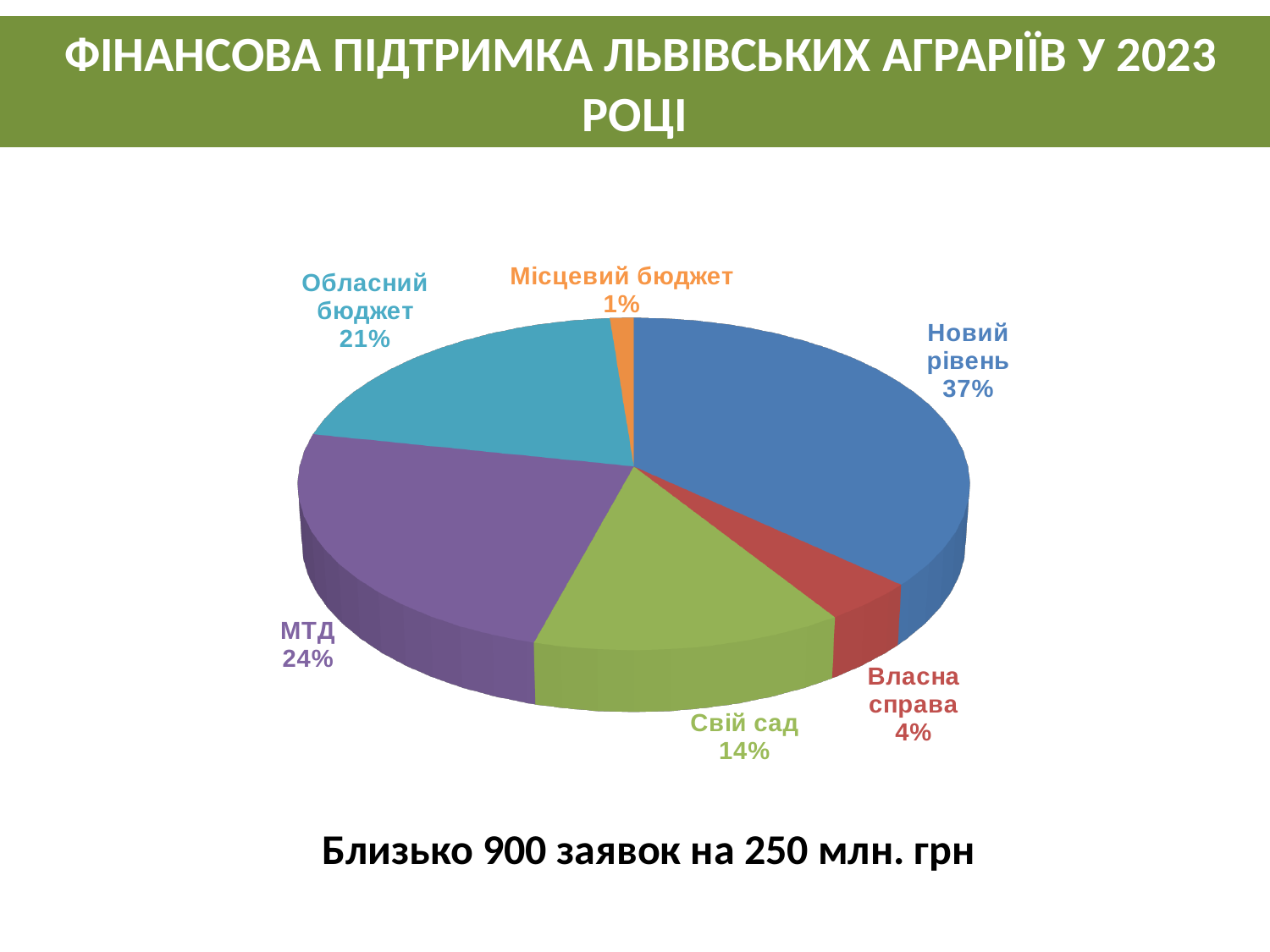
What share of the pie does "Місцевий бюджет" have? 1% What is the difference in percentage points between "Новий рівень" and "МТД"? 13 What share of the pie does "Новий рівень" have? 37% Which category has the largest share of the pie? Новий рівень How many slices does the pie chart have? 6 What kind of chart is shown on the slide? Pie chart What is the title of the slide containing the pie chart? ФІНАНСОВА ПІДТРИМКА ЛЬВІВСЬКИХ АГРАРІЇВ У 2023 РОЦІ What share of the pie does "МТД" have? 24% Which has a larger share, "Свій сад" or "Власна справа"? Свій сад Which category has the smallest share of the pie? Місцевий бюджет